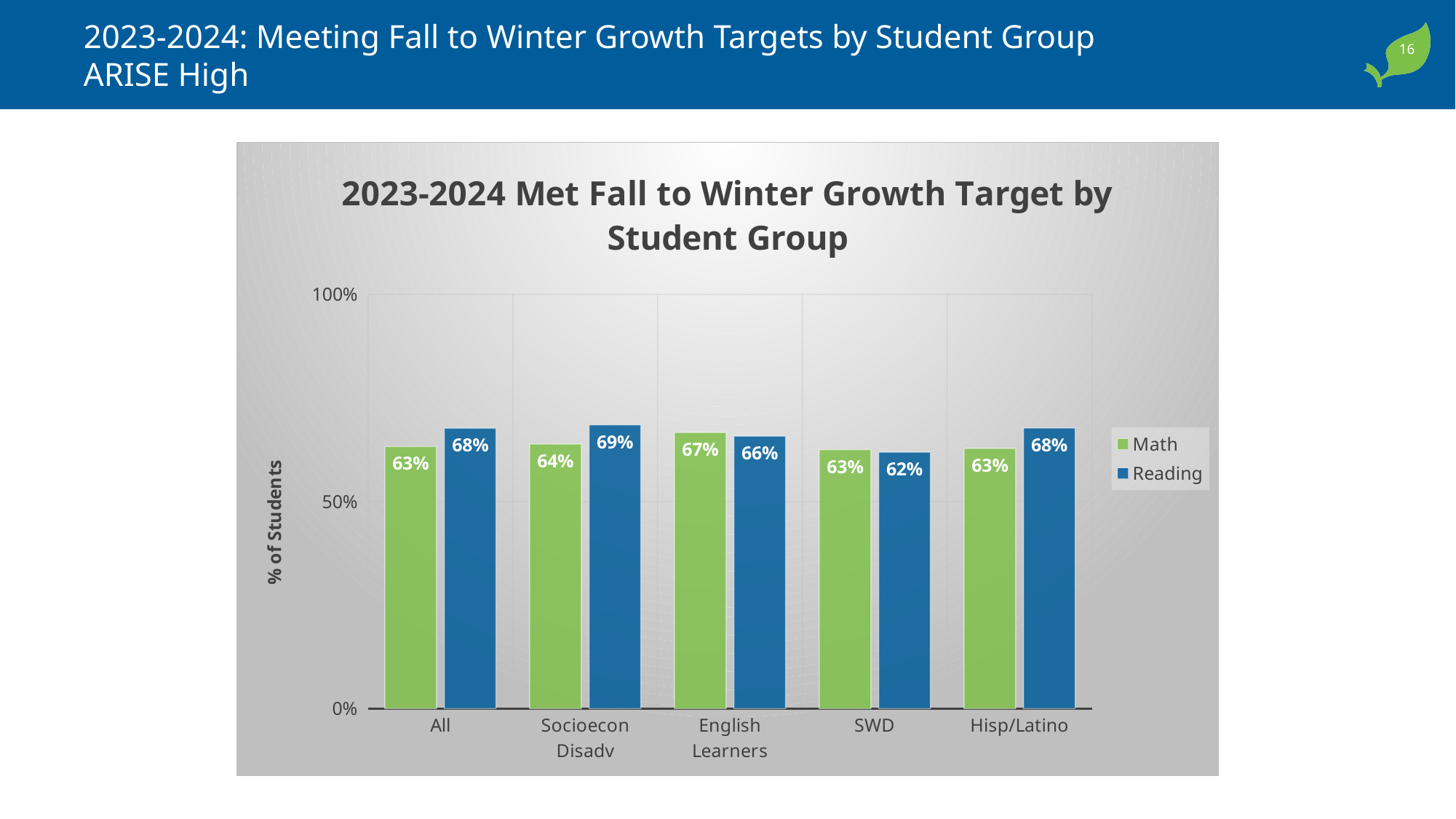
What is the difference between the Reading and Math values for All students? 5% What is the Reading value for Socioecon Disadv? 69% How many student groups are shown on the x axis? 5 What is the Reading value for SWD? 62% For English Learners, which is larger, Math or Reading? Math What is the Math value for Hisp/Latino? 63% What kind of chart is shown on the slide? Bar chart What is the Math value for English Learners? 67% Which student group has the lowest Reading value? SWD Which student group has the highest Reading value? Socioecon Disadv Which student group has the highest Math value? English Learners How many series does the legend list? 2